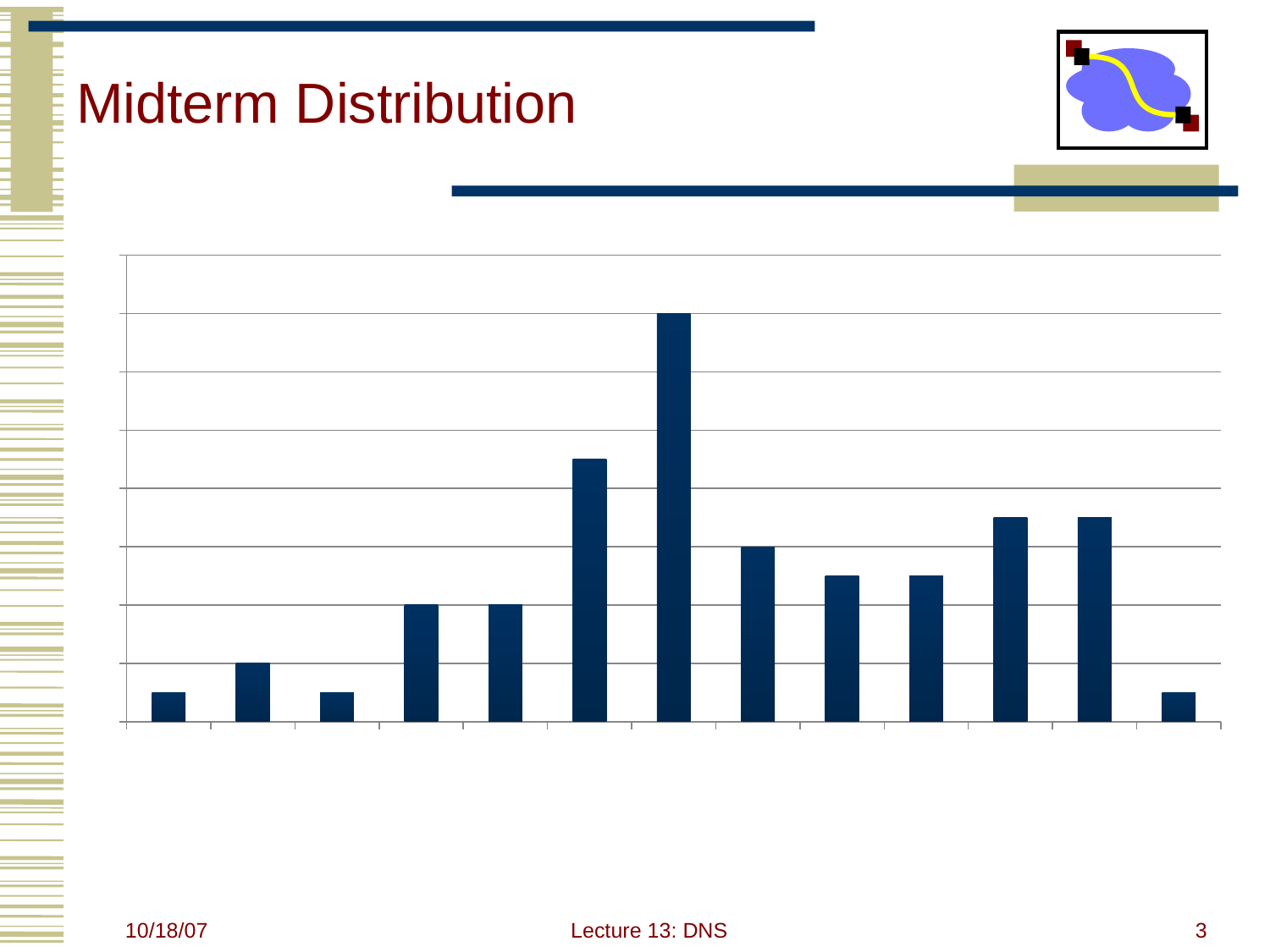
What kind of chart is shown on the slide? bar chart What colour are the bars in the chart? dark blue How many bars does the chart contain? 13 Counting from the left, which bar is the tallest in the chart? the 7th bar Which is taller, the 6th bar from the left or the 8th bar from the left? the 6th bar Which is taller, the 6th bar from the left or the 7th bar from the left? the 7th bar What is the title of the slide containing the chart? Midterm Distribution Which is taller, the 1st bar from the left or the 2nd bar from the left? the 2nd bar